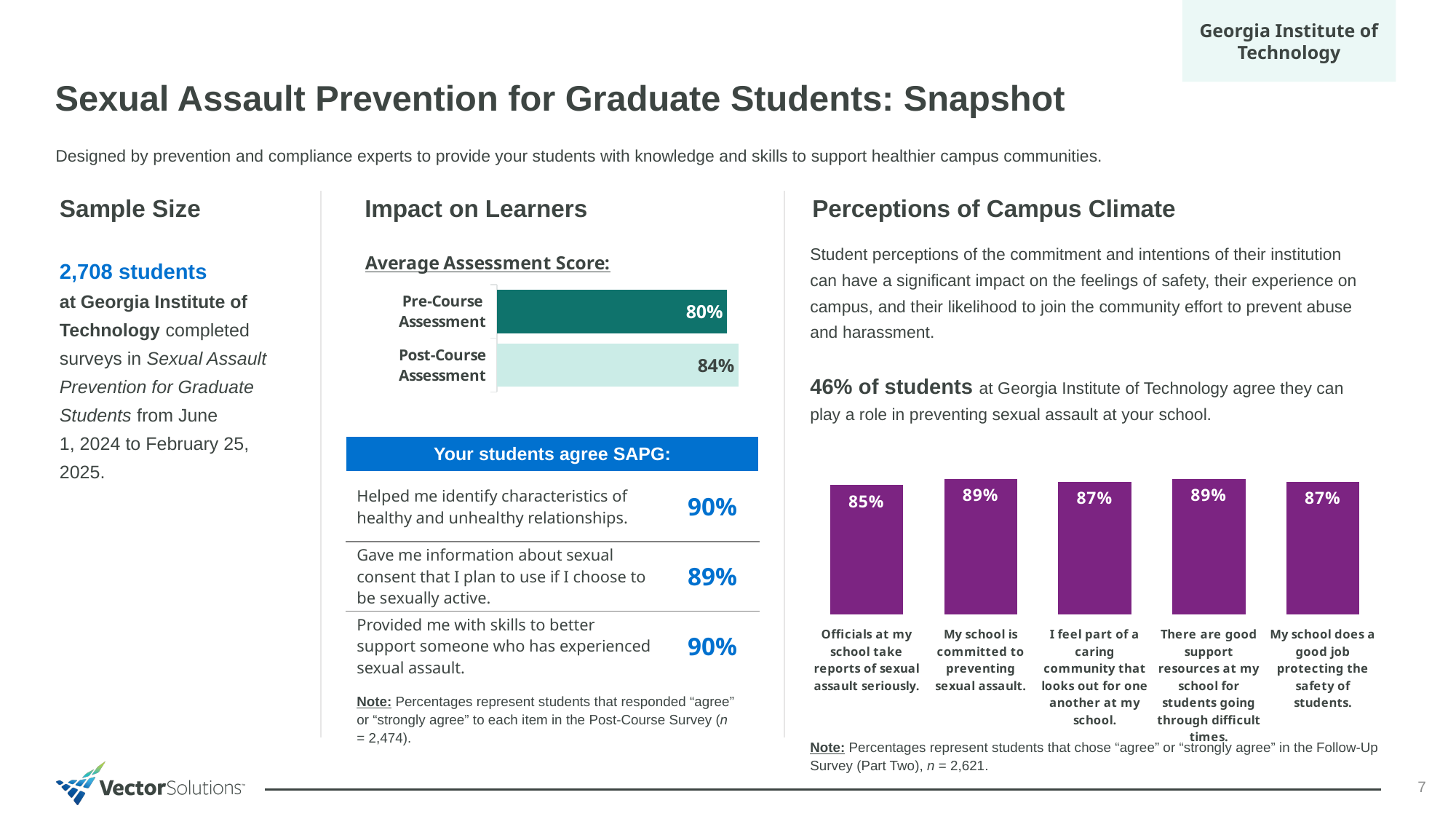
In the Perceptions of Campus Climate chart, what percentage of students agree that officials at their school take reports of sexual assault seriously? 85% In the Perceptions of Campus Climate chart, what is the difference between the percentage for 'My school is committed to preventing sexual assault' and 'Officials at my school take reports of sexual assault seriously'? 4% In the Average Assessment Score chart, what is the value for the Pre-Course Assessment? 80% How many bars does the Perceptions of Campus Climate chart show? 5 What kind of chart is the Average Assessment Score chart? Bar chart In the Perceptions of Campus Climate chart, what percentage of students agree that their school is committed to preventing sexual assault? 89% In the Average Assessment Score chart, which is larger, the Pre-Course or the Post-Course Assessment score? Post-Course Assessment In the Average Assessment Score chart, what is the difference between the Post-Course and Pre-Course Assessment scores? 4% In the Perceptions of Campus Climate chart, which statement has the lowest percentage of agreement? Officials at my school take reports of sexual assault seriously. In the Perceptions of Campus Climate chart, what percentage of students agree that their school does a good job protecting the safety of students? 87% In the Average Assessment Score chart, what is the value for the Post-Course Assessment? 84% How many bars does the Average Assessment Score chart show? 2